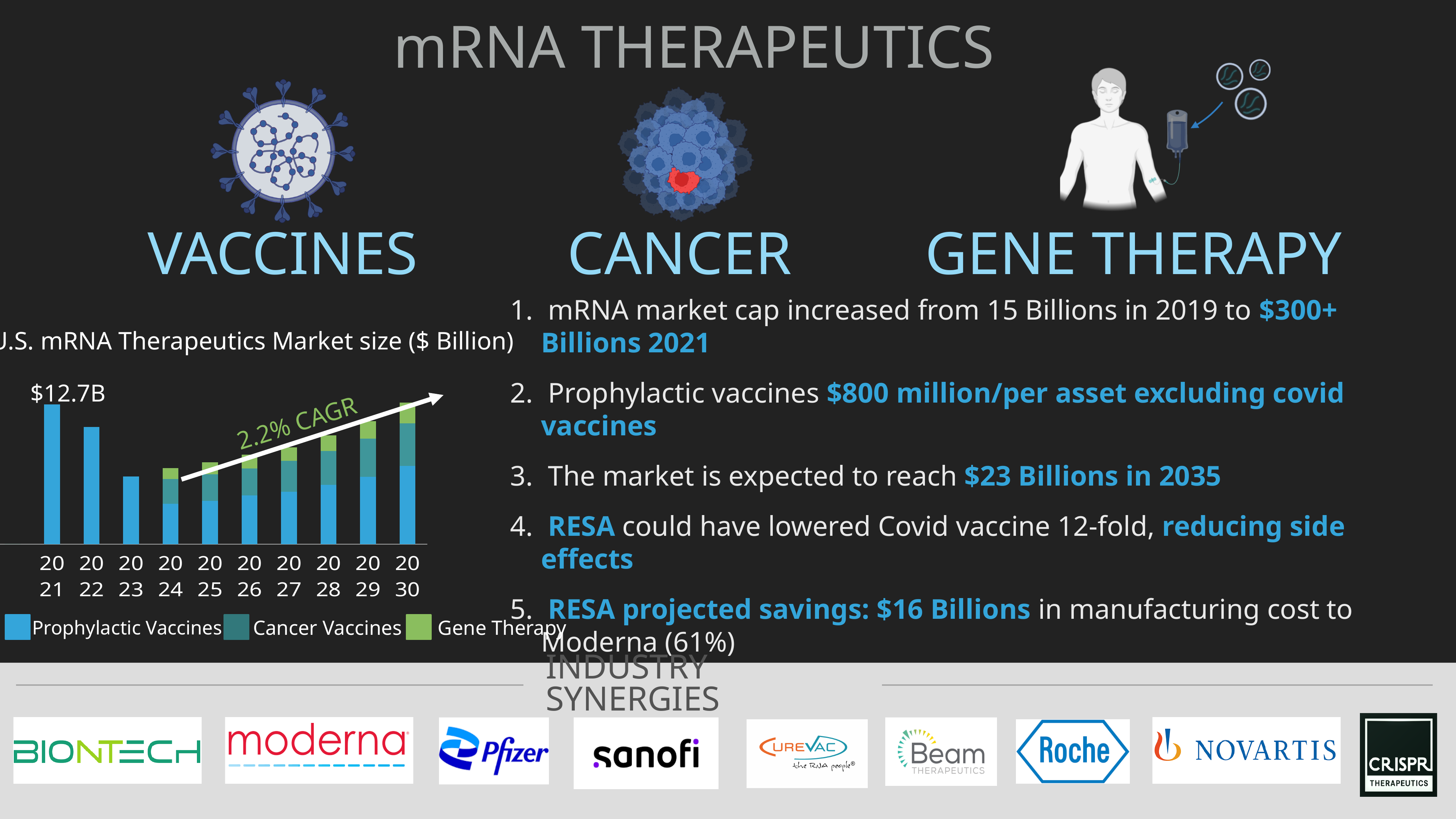
Do the bars in the market size chart rise or fall from 2024 to 2030? rise Do the bars in the market size chart rise or fall from 2021 to 2023? fall Which year has the larger bar in the market size chart, 2022 or 2023? 2022 What is the title of the chart on the slide? U.S. mRNA Therapeutics Market size ($ Billion) Which year has the lowest total bar in the market size chart? 2023 Which year has the larger bar in the market size chart, 2021 or 2023? 2021 How many series does the legend of the market size chart list? 3 Which series forms the bottom segment of each stacked bar in the market size chart? Prophylactic Vaccines What is the labelled market size value for 2021 in the chart? $12.7B How many years are shown on the x axis of the market size chart? 10 What kind of chart is shown under the VACCINES heading? stacked bar chart What CAGR is annotated on the market size chart? 2.2% CAGR